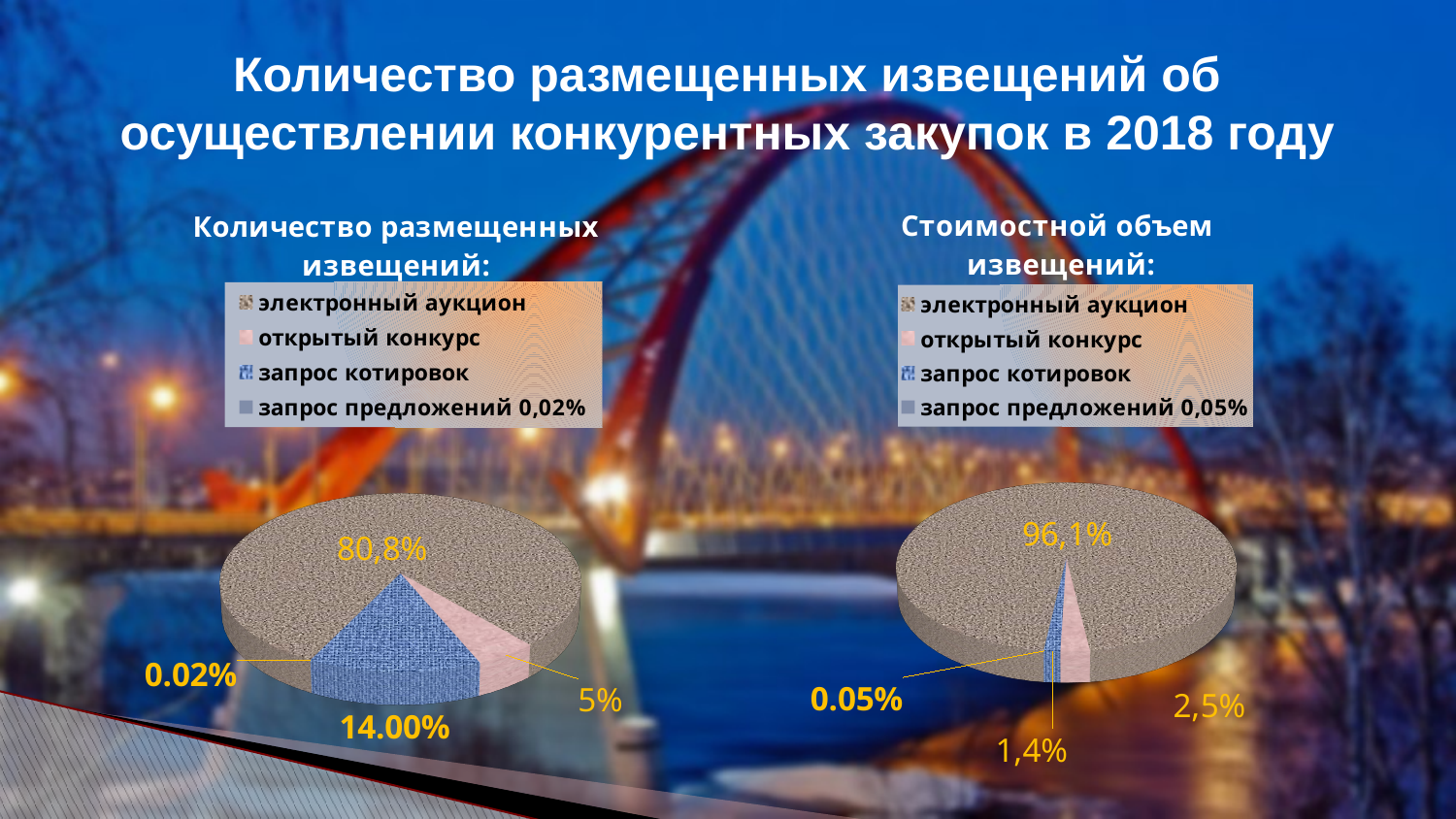
In the right chart 'Стоимостной объем извещений', what share is labelled for электронный аукцион? 96,1% In the left chart 'Количество размещенных извещений', what share is shown for запрос предложений? 0,02% In the right chart 'Стоимостной объем извещений', which category has the largest share? электронный аукцион In the left chart 'Количество размещенных извещений', what share is shown for запрос котировок? 14.00% In the left chart 'Количество размещенных извещений', which category has the smallest share? запрос предложений In the left chart 'Количество размещенных извещений', what share is shown for открытый конкурс? 5% In the left chart 'Количество размещенных извещений', what share is labelled for the largest slice (электронный аукцион)? 80,8% In the right chart 'Стоимостной объем извещений', what share is shown for открытый конкурс? 2,5% In the right chart 'Стоимостной объем извещений', what share is shown for запрос котировок? 1,4% In the left chart 'Количество размещенных извещений', which is larger: the share for запрос котировок or for открытый конкурс? запрос котировок What type of chart is the left chart 'Количество размещенных извещений'? pie chart How many categories does the legend of the right chart 'Стоимостной объем извещений' list? 4